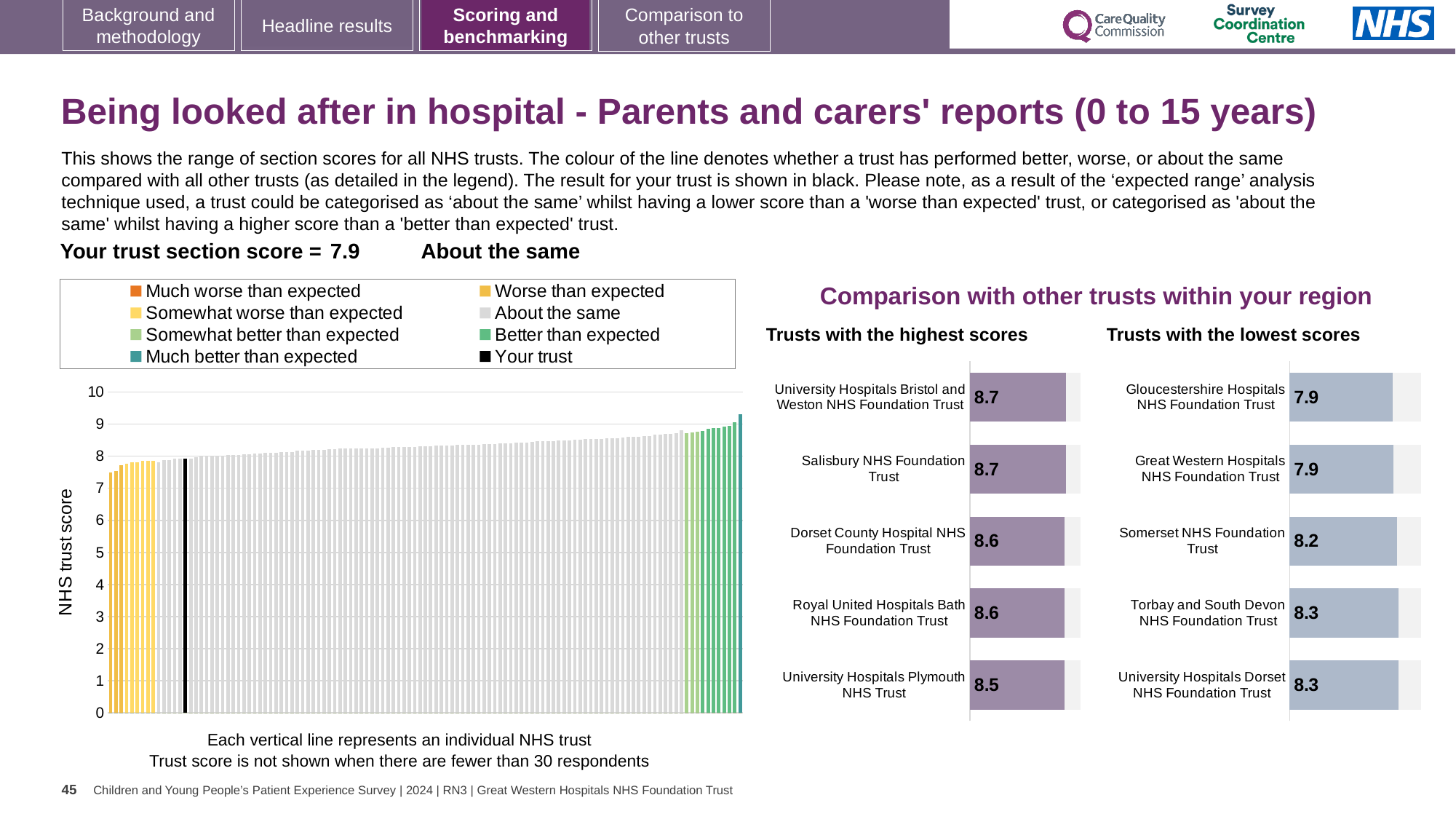
In the 'Trusts with the highest scores' chart, what is the score for Dorset County Hospital NHS Foundation Trust? 8.6 In the 'Trusts with the highest scores' chart, which trust has the lowest score? University Hospitals Plymouth NHS Trust In the 'Trusts with the lowest scores' chart, what is the score for Somerset NHS Foundation Trust? 8.2 In the 'Trusts with the highest scores' chart, what is the difference between the scores of University Hospitals Bristol and Weston NHS Foundation Trust and University Hospitals Plymouth NHS Trust? 0.2 How many entries does the legend of the NHS trust score chart on the left list? 8 According to the slide, what is your trust's section score shown in black on the left chart? 7.9 In the 'Trusts with the highest scores' chart, what is the score for University Hospitals Plymouth NHS Trust? 8.5 In the 'Trusts with the lowest scores' chart, which has the higher score: Somerset NHS Foundation Trust or Gloucestershire Hospitals NHS Foundation Trust? Somerset NHS Foundation Trust In the 'Trusts with the lowest scores' chart, what is the difference between the scores of Torbay and South Devon NHS Foundation Trust and Gloucestershire Hospitals NHS Foundation Trust? 0.4 How many trusts are listed in the 'Trusts with the highest scores' chart? 5 What kind of chart is the NHS trust score chart on the left of the slide? Bar chart In the NHS trust score chart on the left, do the values rise or fall from left to right? Rise